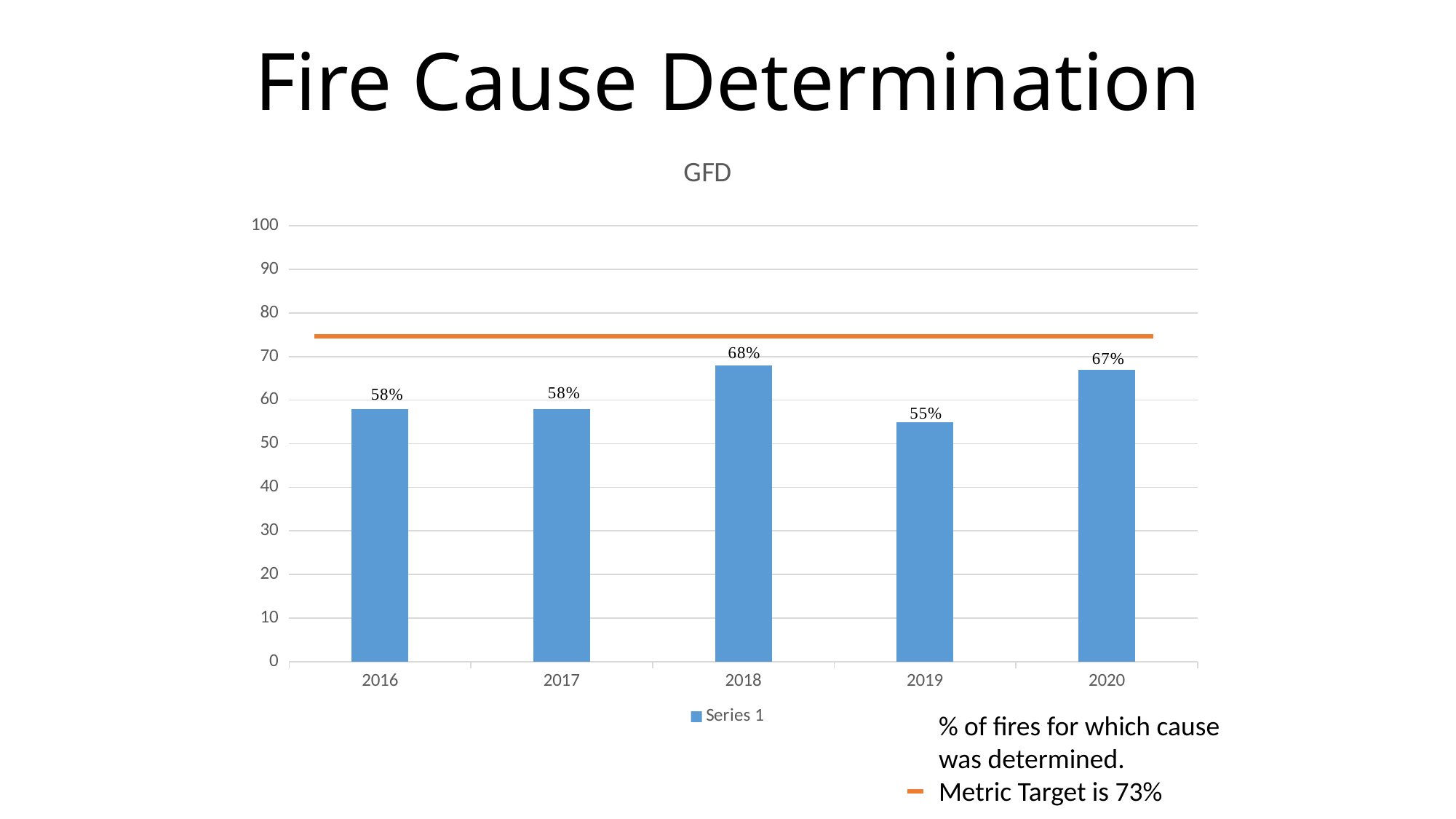
What is the value for 2019? 55% Is the value for 2018 greater or less than 60? greater What is the metric target shown by the orange line? 73% What is the value for 2020? 67% How many years are shown on the x axis? 5 What kind of chart is shown? bar chart What is the title of the chart? GFD Which year has the lowest value? 2019 What is the difference between the values for 2018 and 2019? 13% Which is larger, the value for 2020 or the value for 2017? 2020 What is the value for 2018? 68% Which year has the highest value? 2018